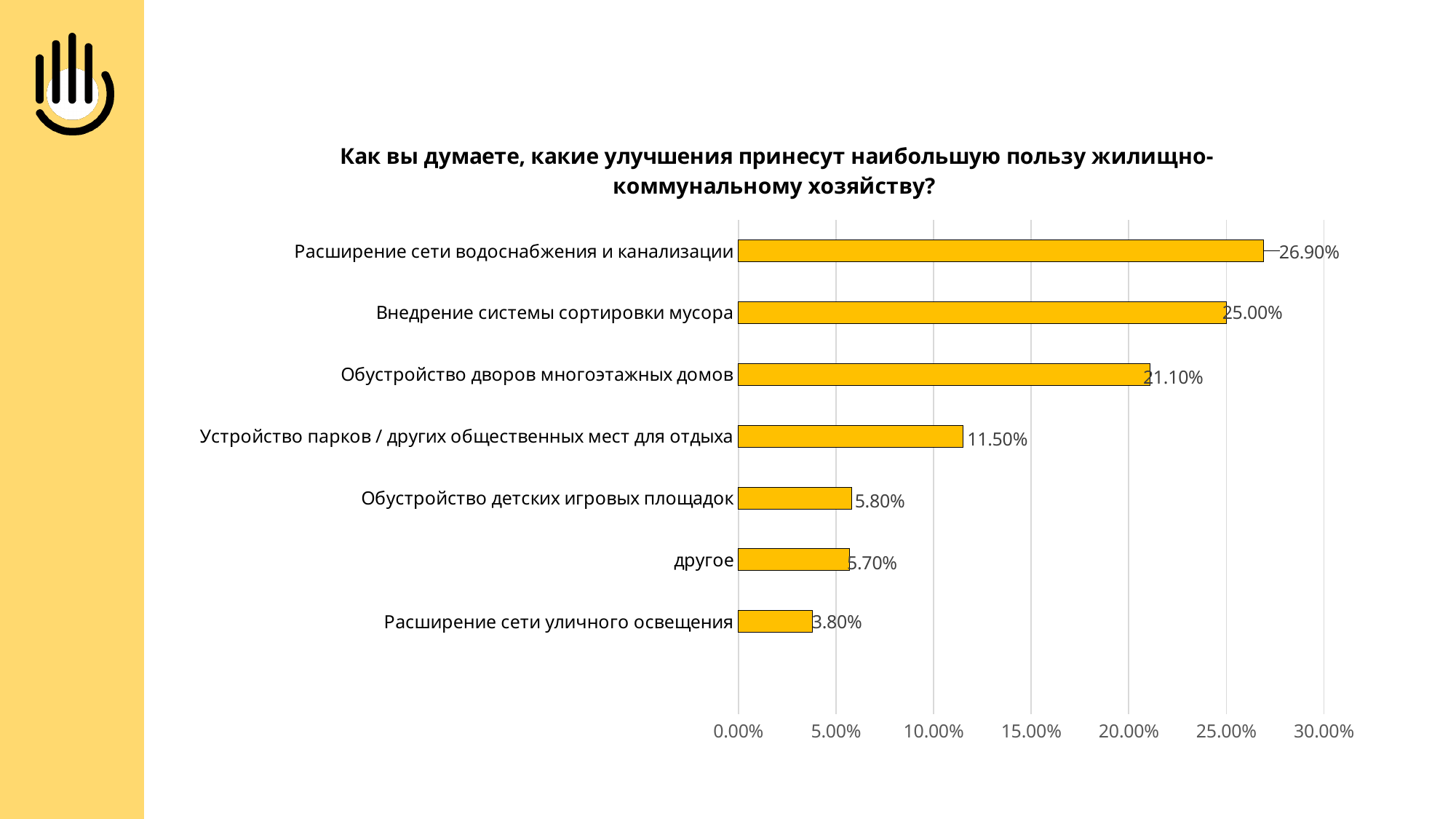
What is the value for "Расширение сети уличного освещения"? 3.80% How many categories are shown in the chart? 7 What is the title of the chart? Как вы думаете, какие улучшения принесут наибольшую пользу жилищно-коммунальному хозяйству? Which category has the lowest value? Расширение сети уличного освещения Which category has the highest value? Расширение сети водоснабжения и канализации Which is larger: the value for "Внедрение системы сортировки мусора" or the value for "Обустройство дворов многоэтажных домов"? Внедрение системы сортировки мусора What is the value for "Устройство парков / других общественных мест для отдыха"? 11.50% Is the value for "Обустройство дворов многоэтажных домов" greater or less than 20.00%? greater What is the difference between the values for "Обустройство дворов многоэтажных домов" and "Устройство парков / других общественных мест для отдыха"? 9.60% What kind of chart is shown on the slide? Bar chart What is the value for "Расширение сети водоснабжения и канализации"? 26.90% What is the value for "Внедрение системы сортировки мусора"? 25.00%